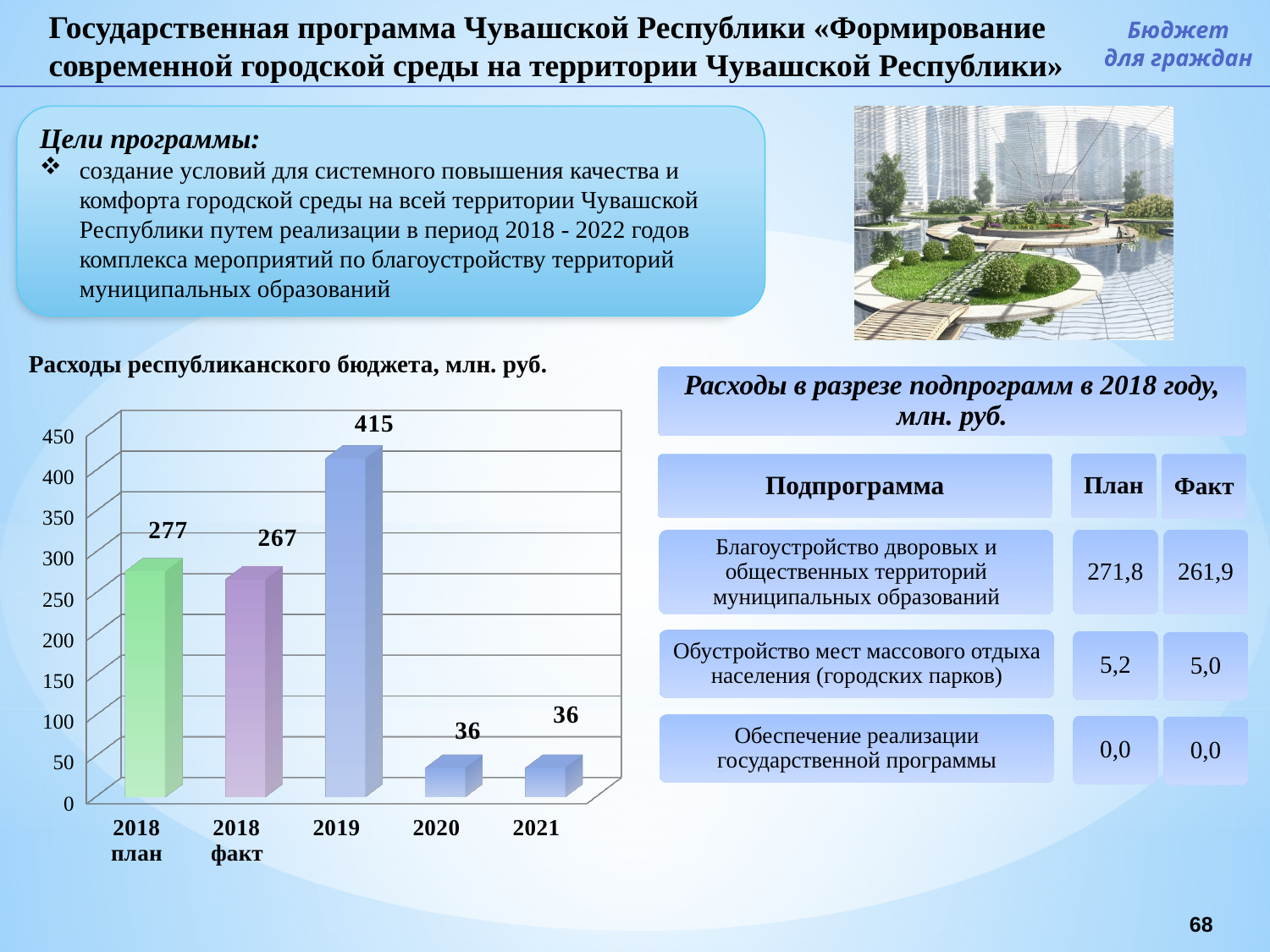
What kind of chart is shown on the slide? bar chart What is the value for 2021 in the chart? 36 Which category has the highest value in the chart? 2019 What is the value for '2018 факт' in the chart? 267 Which is larger, the value for '2018 план' or the value for 2019? 2019 What is the difference between the values for 2019 and 2020? 379 What is the value for 2019 in the chart 'Расходы республиканского бюджета, млн. руб.'? 415 How many categories are shown on the x axis of the chart? 5 Is the value for 2020 greater or less than 50? less What is the difference between the values for '2018 план' and '2018 факт'? 10 What is the value for '2018 план' in the chart? 277 What is the title of the chart on the slide? Расходы республиканского бюджета, млн. руб.